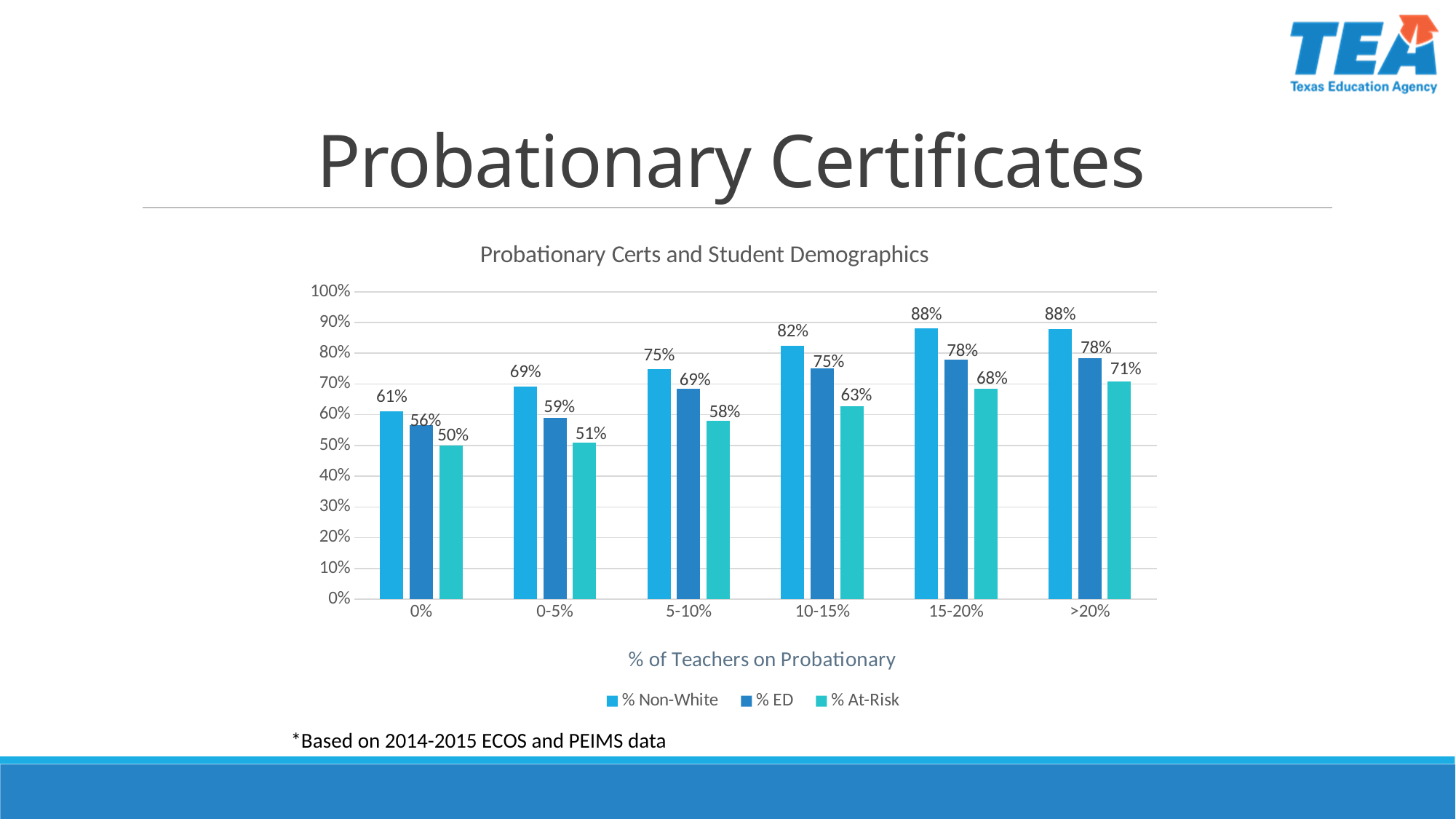
What kind of chart is shown? Bar chart How many categories are shown on the x axis? 6 What is the % ED value for the 0-5% category? 59% Which category has the lowest % At-Risk value? 0% What is the difference between the % Non-White and % At-Risk values for the 5-10% category? 17 percentage points Do the % Non-White values rise or fall from the 0% category to the 15-20% category? Rise What is the % At-Risk value for the >20% category? 71% What is the x-axis label of the chart? % of Teachers on Probationary How many series does the legend list? 3 Which is larger: the % ED value for 10-15% or the % At-Risk value for 15-20%? % ED for 10-15% What is the % Non-White value for the 10-15% category? 82% Which category has the highest % ED value? 15-20% and >20% (both 78%)